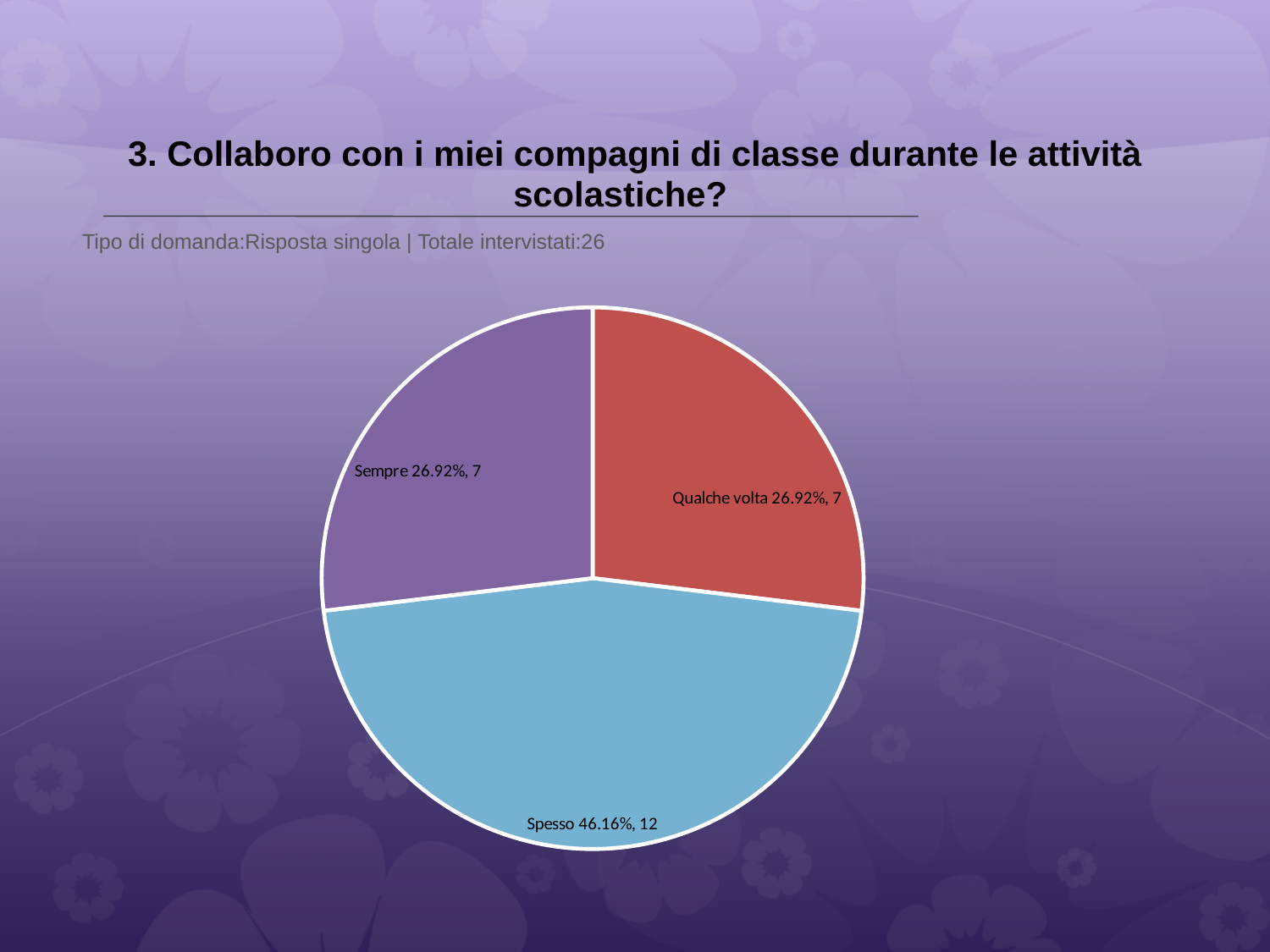
What is the total number of interviewees stated on the slide? 26 What colour is the 'Spesso' slice? blue What is the difference in count between 'Spesso' and 'Sempre'? 5 What percentage share does the 'Spesso' slice have? 46.16% What is the count for the 'Spesso' slice? 12 What percentage share does the 'Qualche volta' slice have? 26.92% How many slices does the pie chart have? 3 What is the total number of respondents across all slices? 26 What is the count for the 'Sempre' slice? 7 Which is larger, the count for 'Spesso' or the count for 'Qualche volta'? Spesso Which response has the largest slice of the pie? Spesso What kind of chart is shown on the slide? pie chart